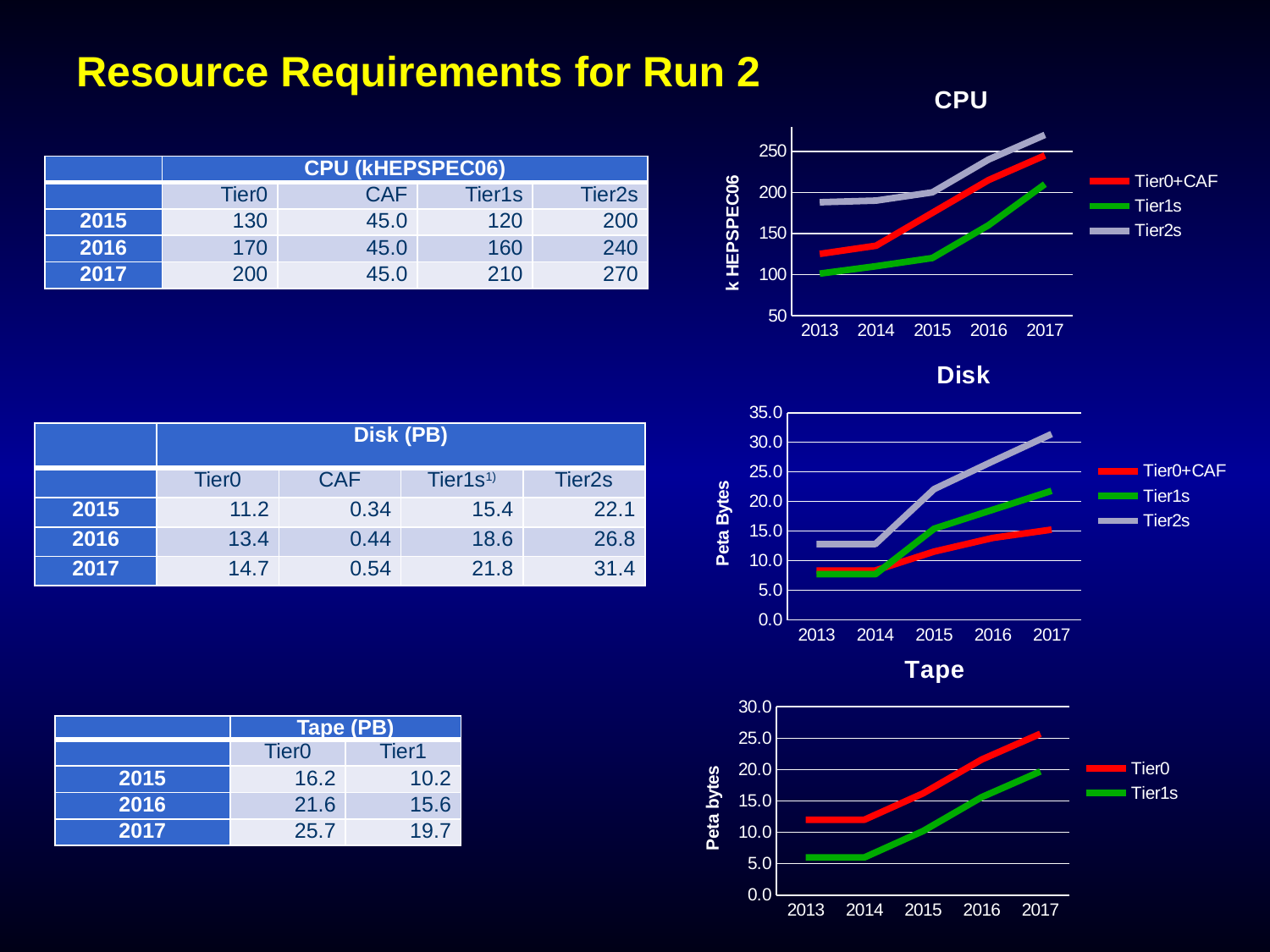
How many series does the legend of the CPU chart list? 3 How many years are shown on the x axis of the CPU chart? 5 In the CPU chart, which series has the highest value in 2017? Tier2s In the Tape chart, which series is higher in 2017, Tier0 or Tier1s? Tier0 What kind of chart is the CPU chart? line chart In the CPU chart, is the value for Tier1s in 2013 greater or less than 150? less How many series does the legend of the Tape chart list? 2 In the Tape chart, is the value for Tier1s in 2013 greater or less than 10.0? less In the CPU chart, is the value for Tier2s in 2013 greater or less than 150? greater In the Disk chart, does the Tier1s series rise or fall from 2013 to 2017? rises How many series does the legend of the Disk chart list? 3